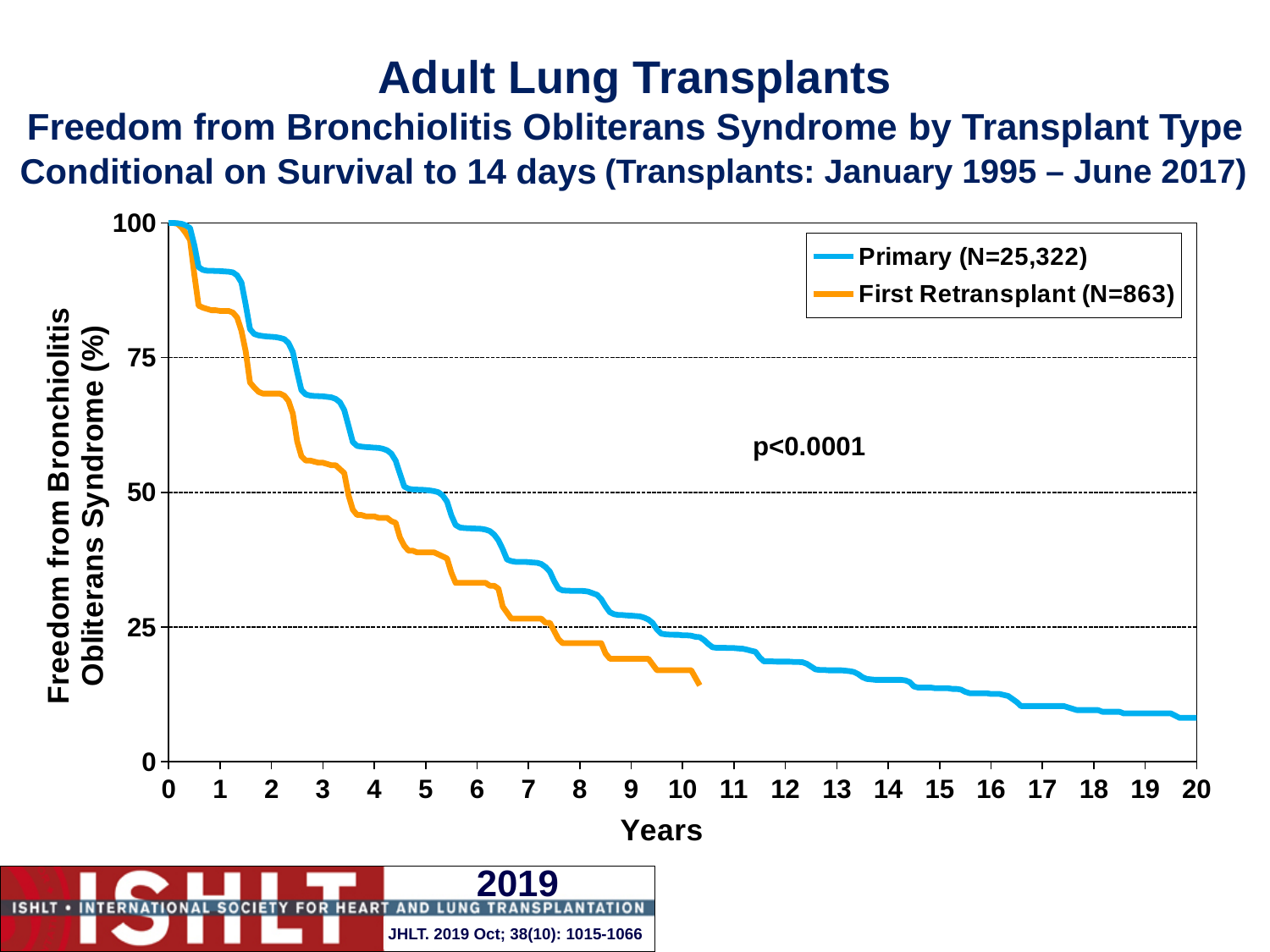
Which series extends further along the x axis, Primary or First Retransplant? Primary How many series does the legend list? 2 What kind of chart is shown on the slide? line chart Is the value for First Retransplant at 5 years greater or less than 50? less Is the value for First Retransplant at 2 years greater or less than 75? less At 5 years, which series has the higher freedom from Bronchiolitis Obliterans Syndrome, Primary or First Retransplant? Primary What is the N for the Primary series given in the legend? N=25,322 What p-value is shown on the chart? p<0.0001 Is the value for Primary at 3 years greater or less than 50? greater Do the values for the Primary series rise or fall as years increase? fall